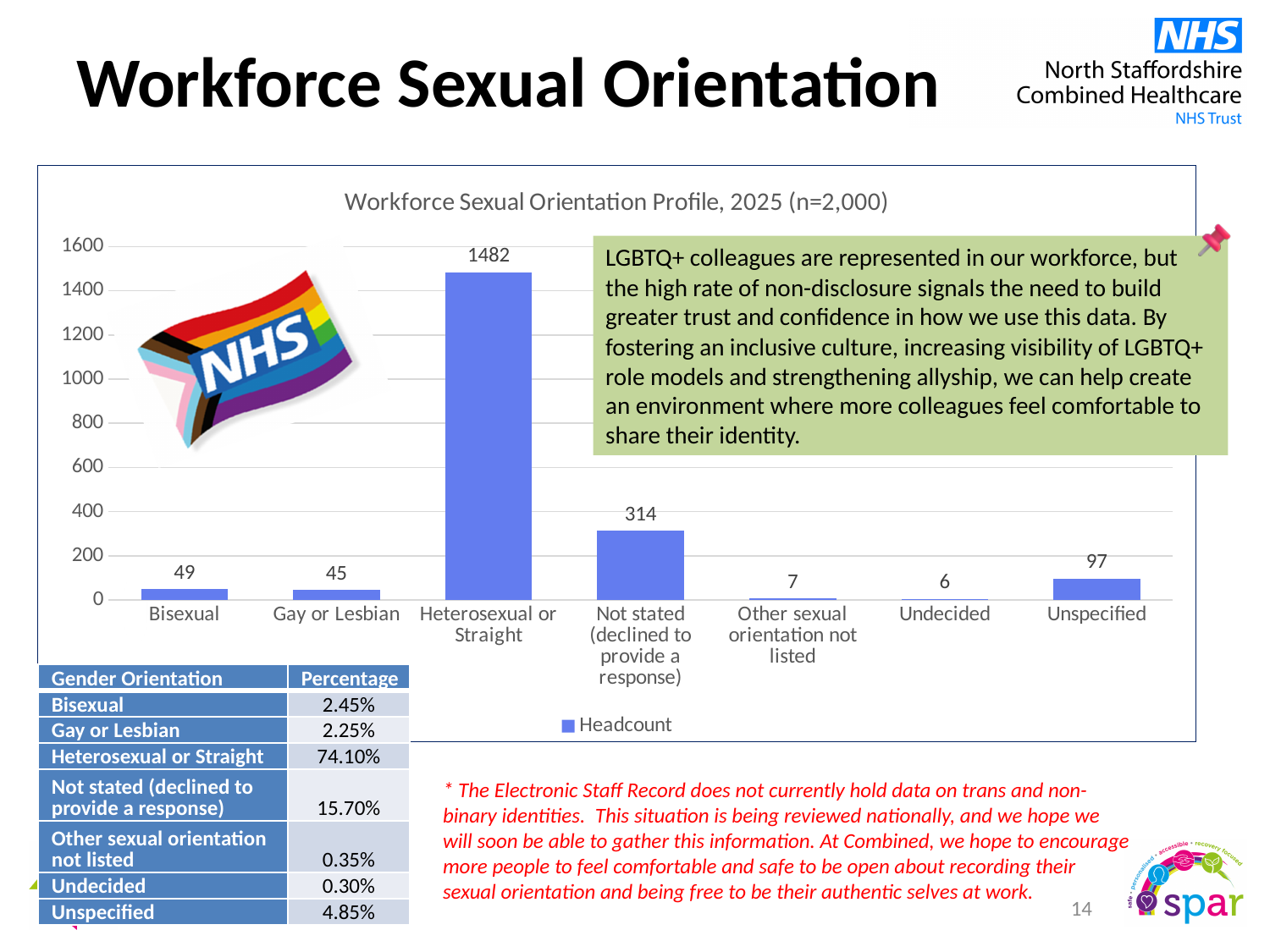
What is the headcount for Not stated (declined to provide a response)? 314 Is the headcount for Not stated (declined to provide a response) greater or less than 400? less What is the headcount for Unspecified? 97 How many categories are shown on the x axis of the chart? 7 Which has a larger headcount, Bisexual or Gay or Lesbian? Bisexual What is the headcount for Bisexual? 49 What is the title of the chart? Workforce Sexual Orientation Profile, 2025 (n=2,000) What kind of chart is shown on the slide? Bar chart What is the difference in headcount between Heterosexual or Straight and Not stated (declined to provide a response)? 1168 How many series does the chart legend list? 1 Which category has the highest headcount? Heterosexual or Straight Which category has the lowest headcount? Undecided